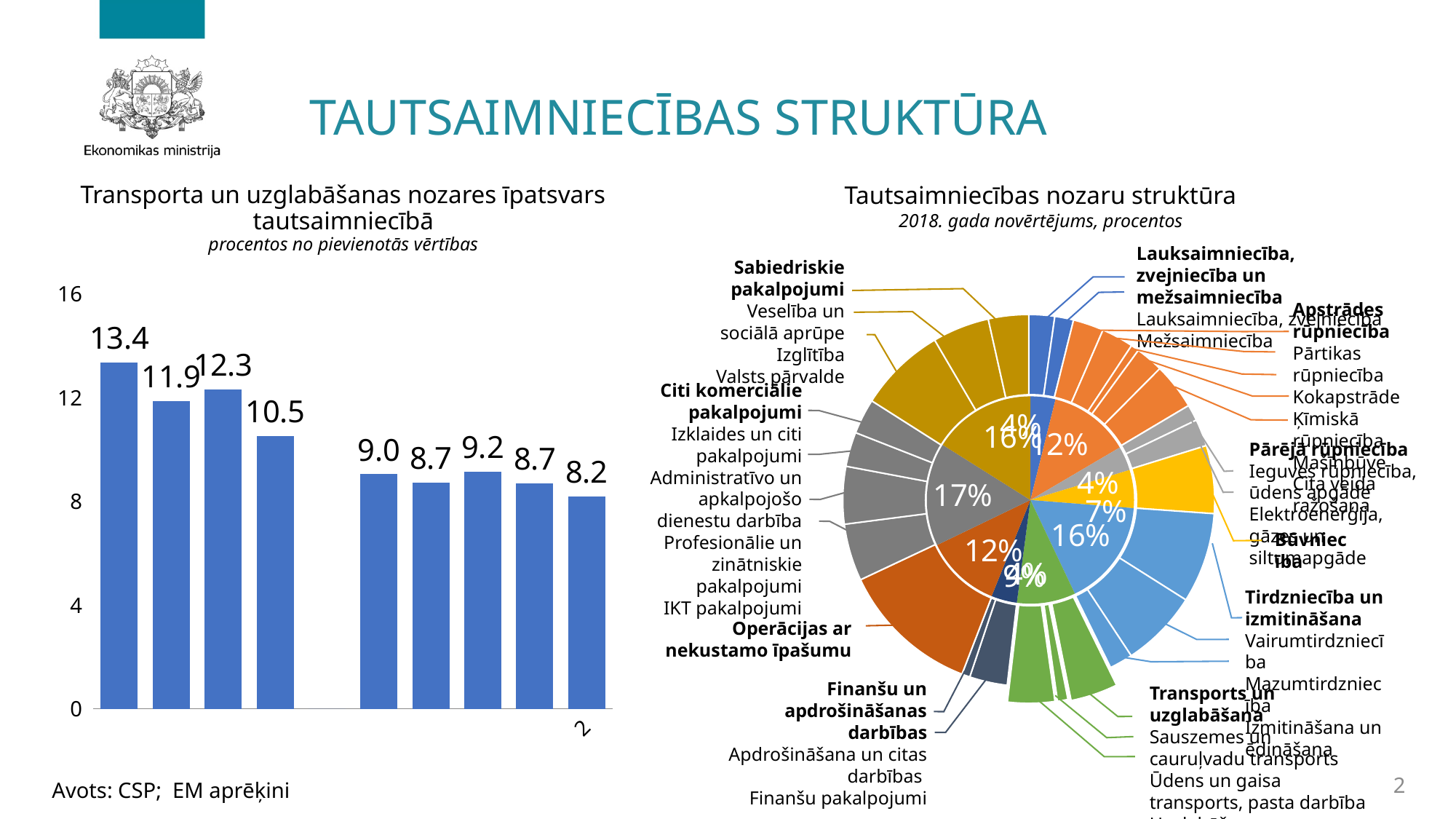
In the left bar chart, do the values generally rise or fall from left to right? fall What kind of chart is the right chart, 'Tautsaimniecības nozaru struktūra'? pie chart In the left bar chart, which is larger: the first bar or the fourth bar? the first bar (13.4) In the right pie chart, what share is shown for 'Citi komerciālie pakalpojumi'? 17% What kind of chart is the left chart, 'Transporta un uzglabāšanas nozares īpatsvars tautsaimniecībā'? bar chart In the left bar chart, what is the difference between the highest value (13.4) and the lowest value (8.2)? 5.2 In the left bar chart, what is the value of the last (rightmost) bar? 8.2 In the left bar chart, is the value of the first bar greater or less than 12? greater In the left bar chart, what is the value of the first (leftmost) bar? 13.4 In the left bar chart, what is the highest value shown? 13.4 In the left bar chart, what is the lowest value shown? 8.2 In the left bar chart, how many bars are plotted? 9